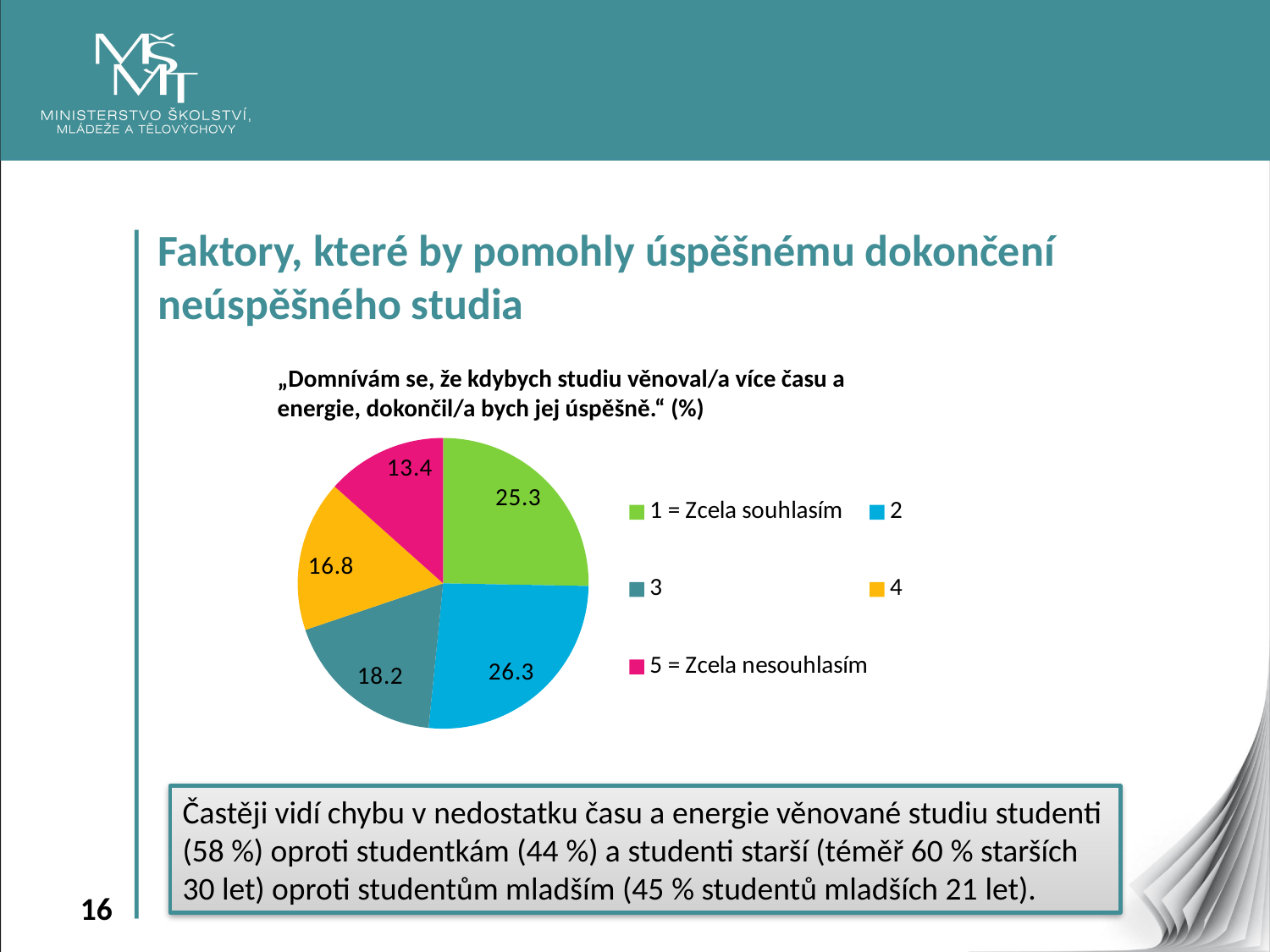
Which category has the largest slice in the pie chart? 2 What is the value for category "4" in the pie chart? 16.8 Which is larger: the value for "1 = Zcela souhlasím" or the value for "5 = Zcela nesouhlasím"? 1 = Zcela souhlasím What is the difference between the values for category "3" and category "4"? 1.4 What kind of chart is shown on the slide? pie chart Which category has the smallest slice in the pie chart? 5 = Zcela nesouhlasím How many slices does the pie chart have? 5 What colour is the slice for category "4" in the pie chart? yellow What is the value for "5 = Zcela nesouhlasím" in the pie chart? 13.4 What is the value for "1 = Zcela souhlasím" in the pie chart? 25.3 What is the value for category "2" in the pie chart? 26.3 What is the value for category "3" in the pie chart? 18.2